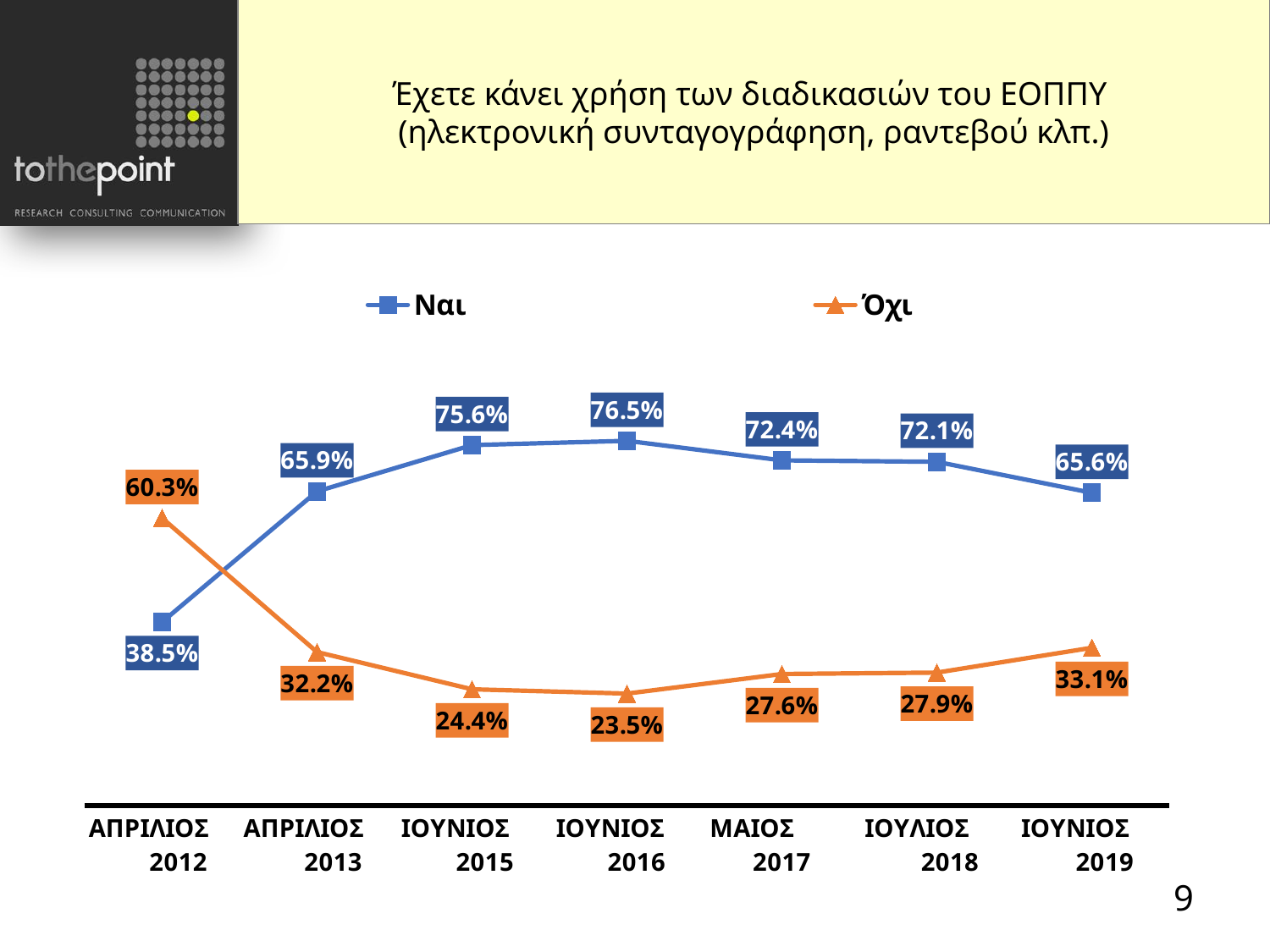
In which period does the Ναι series reach its highest value? ΙΟΥΝΙΟΣ 2016 What kind of chart is shown on the slide? Line chart How many time periods are shown on the x axis? 7 How many series does the legend list? 2 What is the value of the Όχι series for ΜΑΙΟΣ 2017? 27.6% Which series has the larger value in ΑΠΡΙΛΙΟΣ 2012, Ναι or Όχι? Όχι Does the Όχι series rise or fall from ΑΠΡΙΛΙΟΣ 2012 to ΙΟΥΝΙΟΣ 2016? Fall What is the value of the Ναι series for ΙΟΥΝΙΟΣ 2016? 76.5% What is the difference between the Ναι values for ΙΟΥΝΙΟΣ 2015 and ΑΠΡΙΛΙΟΣ 2013? 9.7% What is the value of the Όχι series for ΑΠΡΙΛΙΟΣ 2012? 60.3% In which period does the Όχι series have its lowest value? ΙΟΥΝΙΟΣ 2016 What is the value of the Ναι series for ΙΟΥΝΙΟΣ 2019? 65.6%